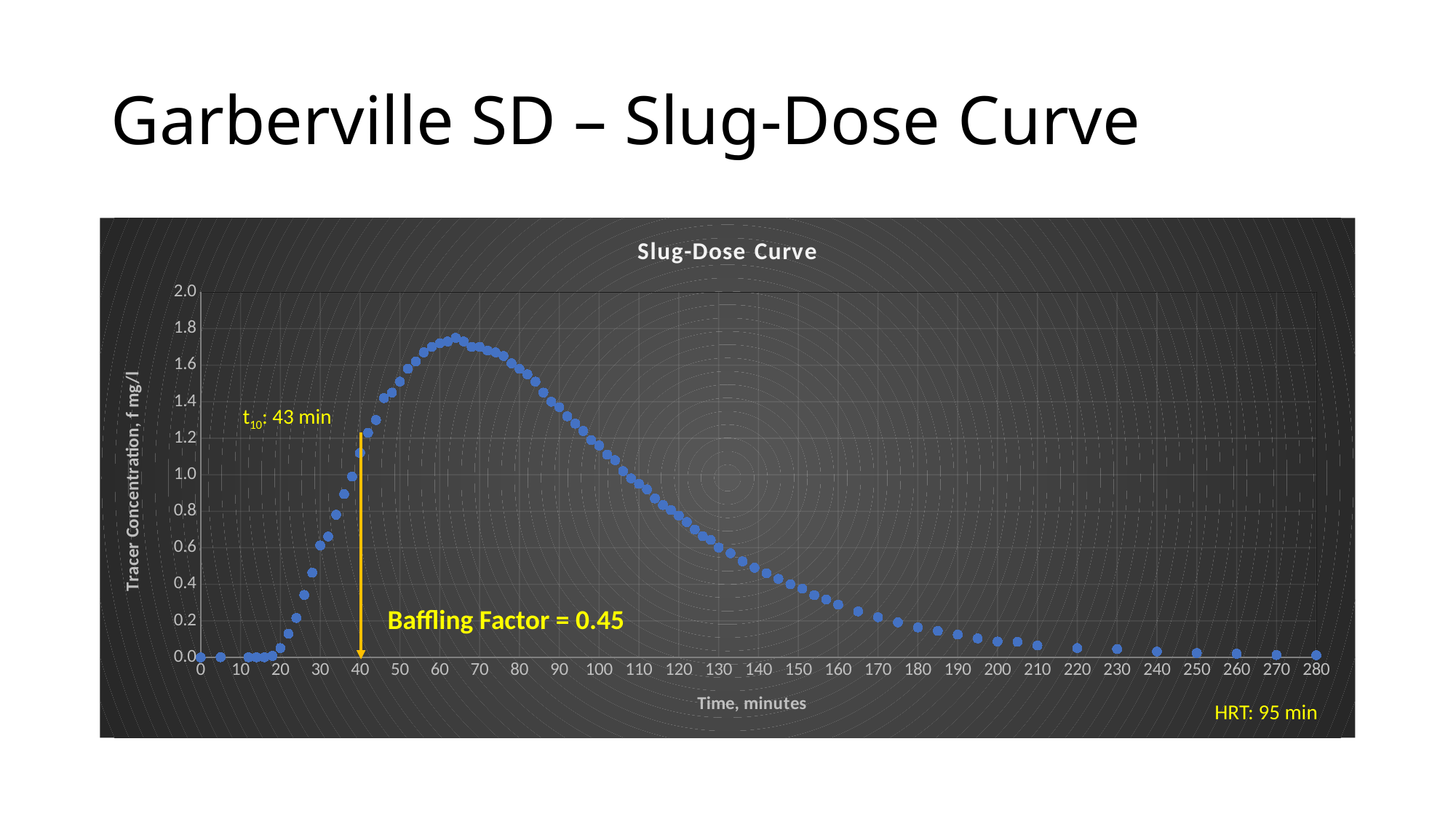
Is the tracer concentration at 20 minutes greater or less than 0.4? less Do the tracer concentration values rise or fall between 100 and 280 minutes? fall Is the tracer concentration at 200 minutes greater or less than 0.2? less Is the tracer concentration at 60 minutes greater or less than 1.4? greater Which is larger, the tracer concentration at 60 minutes or at 200 minutes? 60 minutes What is the title of the chart? Slug-Dose Curve What kind of chart is shown on the slide? scatter chart What Baffling Factor is annotated on the chart? 0.45 Which is larger, the tracer concentration at 30 minutes or at 80 minutes? 80 minutes